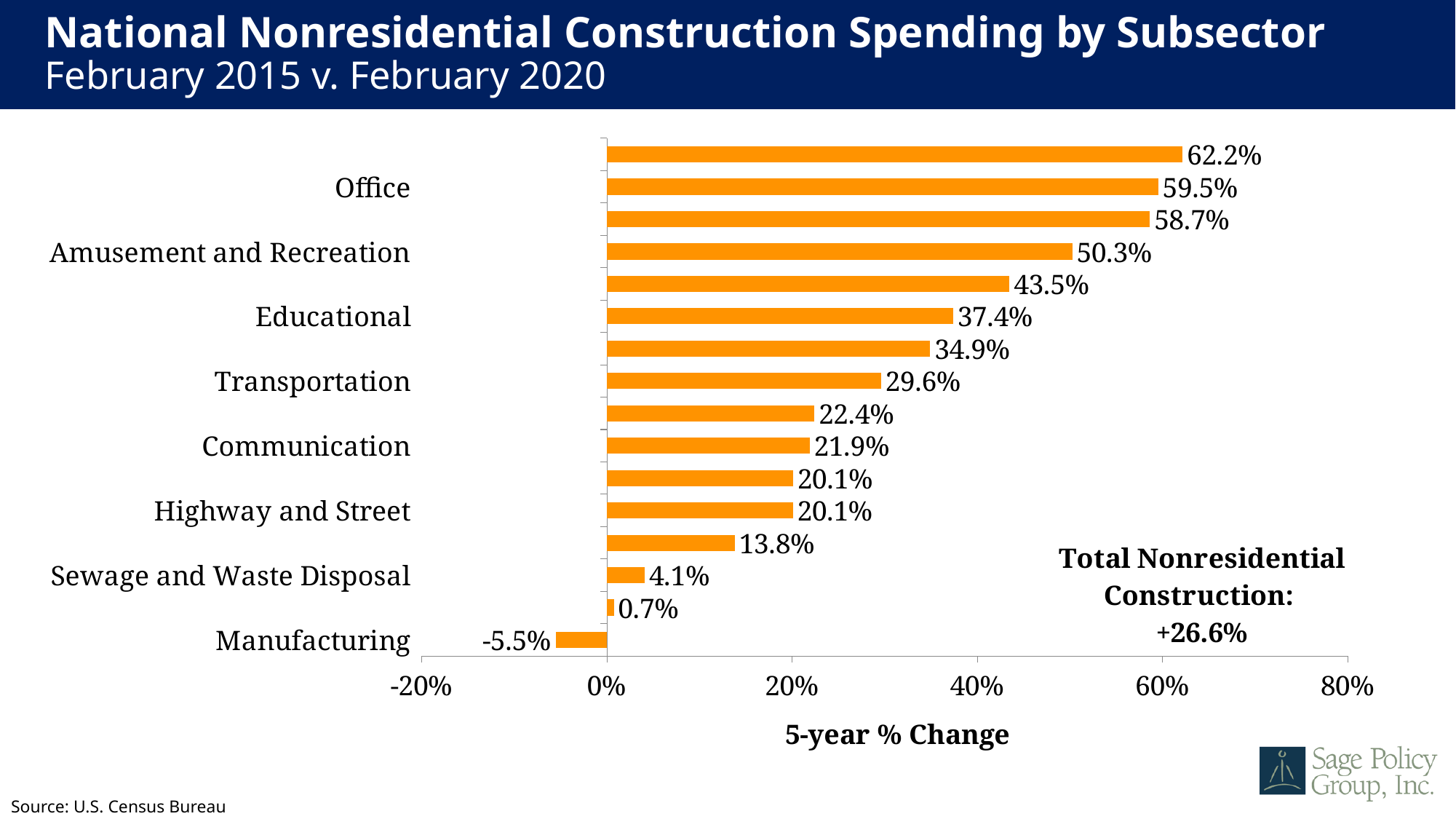
What is the 5-year % change for Educational? 37.4% What is the 5-year % change for Total Nonresidential Construction noted on the chart? +26.6% What is the 5-year % change for Office? 59.5% Which has a larger 5-year % change, Communication or Highway and Street? Communication Which labeled subsector has the lowest 5-year % change? Manufacturing What is the difference in 5-year % change between Office and Amusement and Recreation? 9.2 percentage points What is the 5-year % change for Transportation? 29.6% What is the 5-year % change for Manufacturing? -5.5% What type of chart is shown on the slide? Bar chart How many bars are plotted on the chart? 16 What is the highest 5-year % change value shown on the chart? 62.2% What is the 5-year % change for Sewage and Waste Disposal? 4.1%